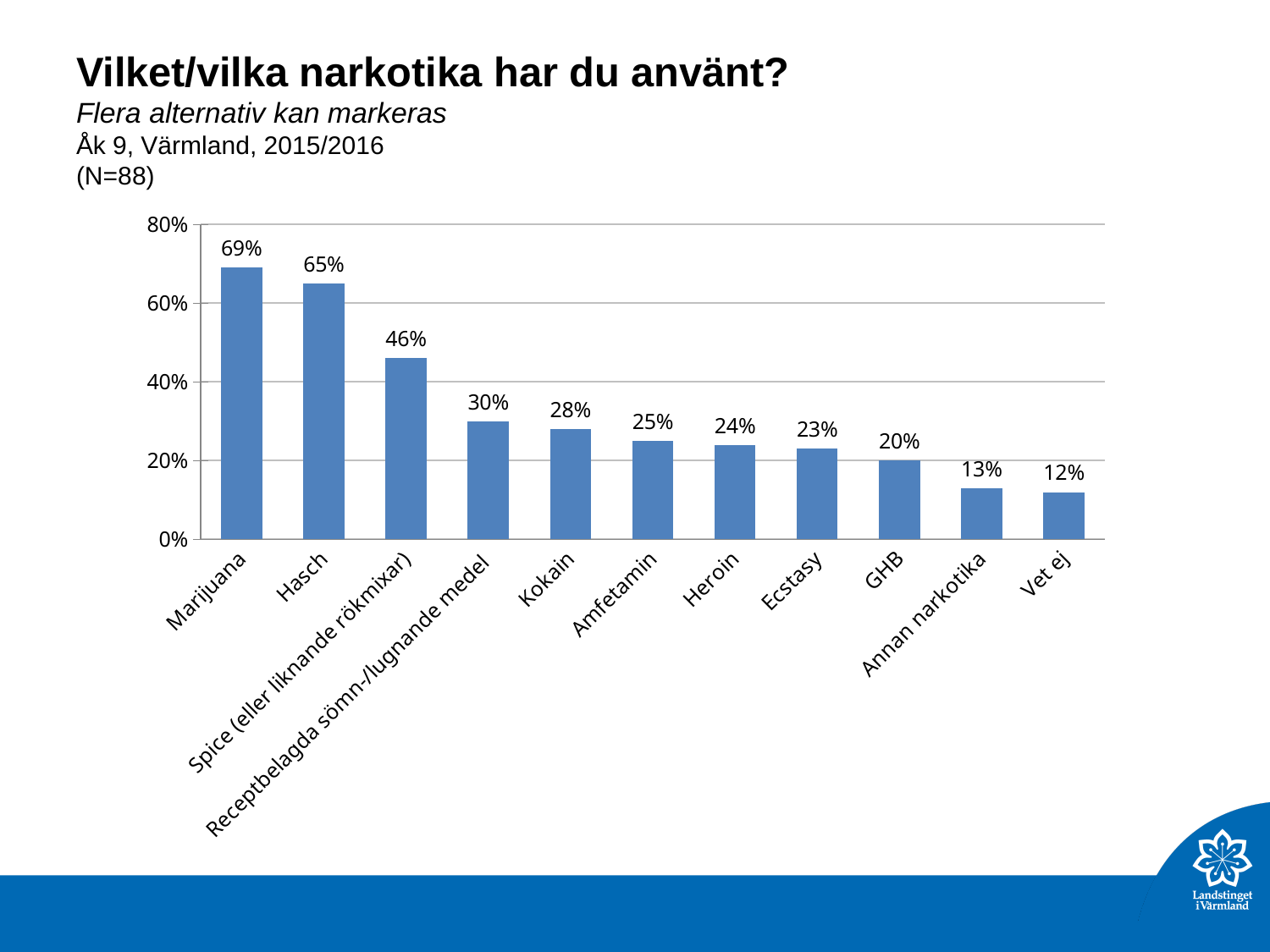
What kind of chart is shown on the slide? bar chart Which category has the highest value? Marijuana Do the values rise or fall from left to right along the x axis? fall What is the value for Receptbelagda sömn-/lugnande medel? 30% How many categories are shown on the x axis? 11 What is the difference between the values for Marijuana and Hasch? 4% What is the difference between the values for Spice (eller liknande rökmixar) and Kokain? 18% Which is larger, the value for Amfetamin or the value for Ecstasy? Amfetamin Is the value for Hasch greater or less than 60%? greater Which category has the lowest value? Vet ej What is the value for GHB? 20% What is the value for Marijuana? 69%